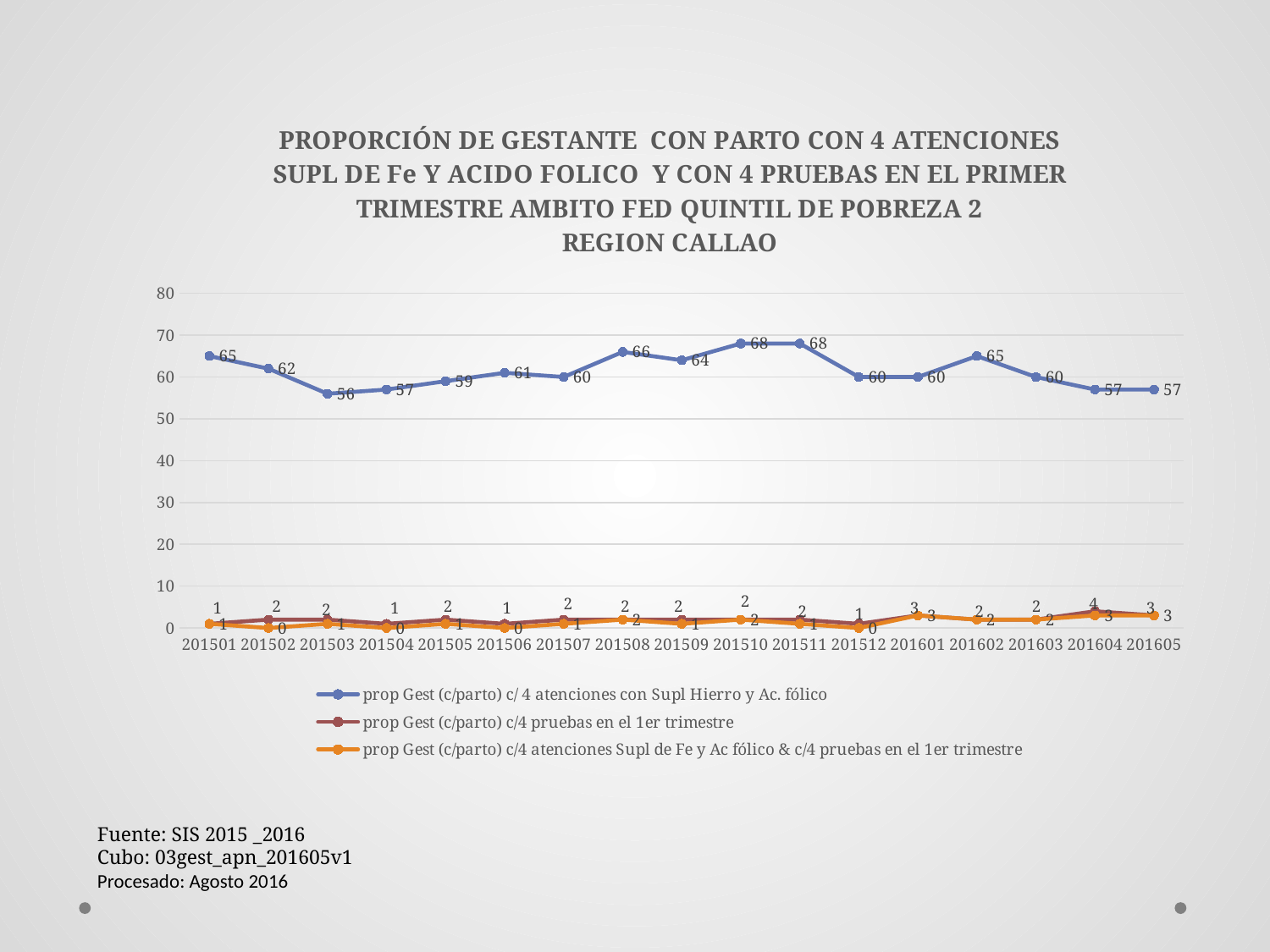
What kind of chart is shown on the slide? line chart In which period does the series 'prop Gest (c/parto) c/ 4 atenciones con Supl Hierro y Ac. fólico' reach its lowest value? 201503 What is the value of the series 'prop Gest (c/parto) c/4 pruebas en el 1er trimestre' for 201604? 4 How many periods are plotted along the x axis? 17 For the series 'prop Gest (c/parto) c/ 4 atenciones con Supl Hierro y Ac. fólico', which period has the larger value, 201508 or 201509? 201508 Does the series 'prop Gest (c/parto) c/ 4 atenciones con Supl Hierro y Ac. fólico' rise or fall from 201511 to 201605? fall What is the value of the series 'prop Gest (c/parto) c/ 4 atenciones con Supl Hierro y Ac. fólico' for 201503? 56 What is the highest value reached by the series 'prop Gest (c/parto) c/ 4 atenciones con Supl Hierro y Ac. fólico'? 68 What is the difference between the values of the series 'prop Gest (c/parto) c/ 4 atenciones con Supl Hierro y Ac. fólico' for 201510 and 201501? 3 What is the value of the series 'prop Gest (c/parto) c/ 4 atenciones con Supl Hierro y Ac. fólico' for 201501? 65 How many series does the legend list? 3 What is the value of the series 'prop Gest (c/parto) c/4 atenciones Supl de Fe y Ac fólico & c/4 pruebas en el 1er trimestre' for 201502? 0